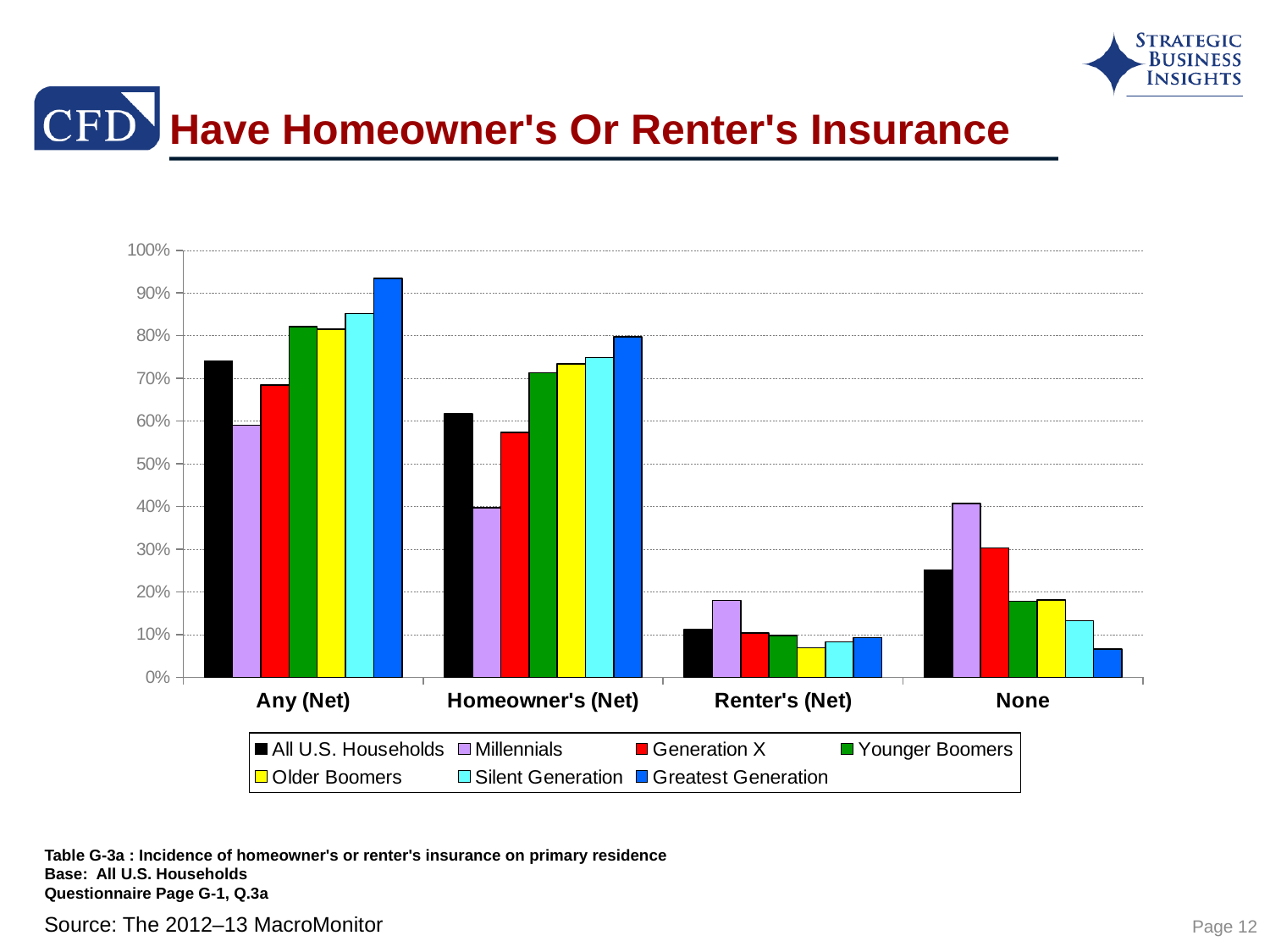
Which series has the highest value for Any (Net)? Greatest Generation Is the value for Greatest Generation in Any (Net) greater or less than 90%? greater Which series has the lowest value for None? Greatest Generation Is the value for Millennials in Homeowner's (Net) greater or less than 50%? less Which series has the highest value for None? Millennials How many categories are shown along the x axis? 4 Which series has the highest value for Renter's (Net)? Millennials For None, which is larger: Millennials or Generation X? Millennials What is the title of the slide's chart? Have Homeowner's Or Renter's Insurance How many series does the legend list? 7 Which series has the lowest value for Any (Net)? Millennials What kind of chart is shown on the slide? bar chart